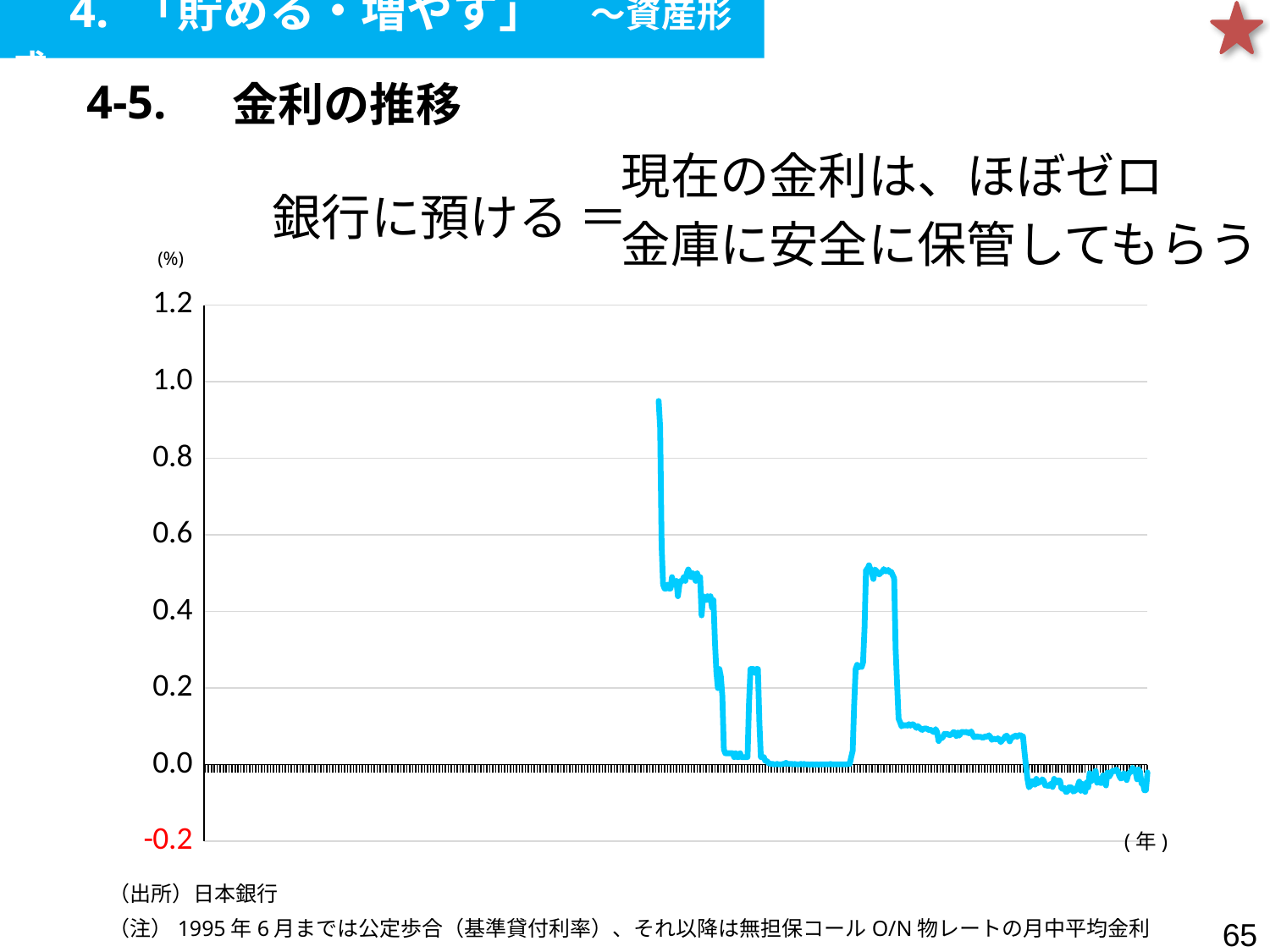
What is the lowest value labelled on the vertical axis? -0.2 Is the highest value reached by the line greater or less than 0.8? greater What kind of chart is shown on the slide? line chart What is the title of the chart on the slide? 金利の推移 Is the highest value reached by the line greater or less than 1.0? less What is the highest value labelled on the vertical axis? 1.2 How many lines are plotted on the chart? 1 Overall, do the values of the line rise or fall from left to right along the x axis? fall Is the value at the right end of the line greater or less than 0.0? less